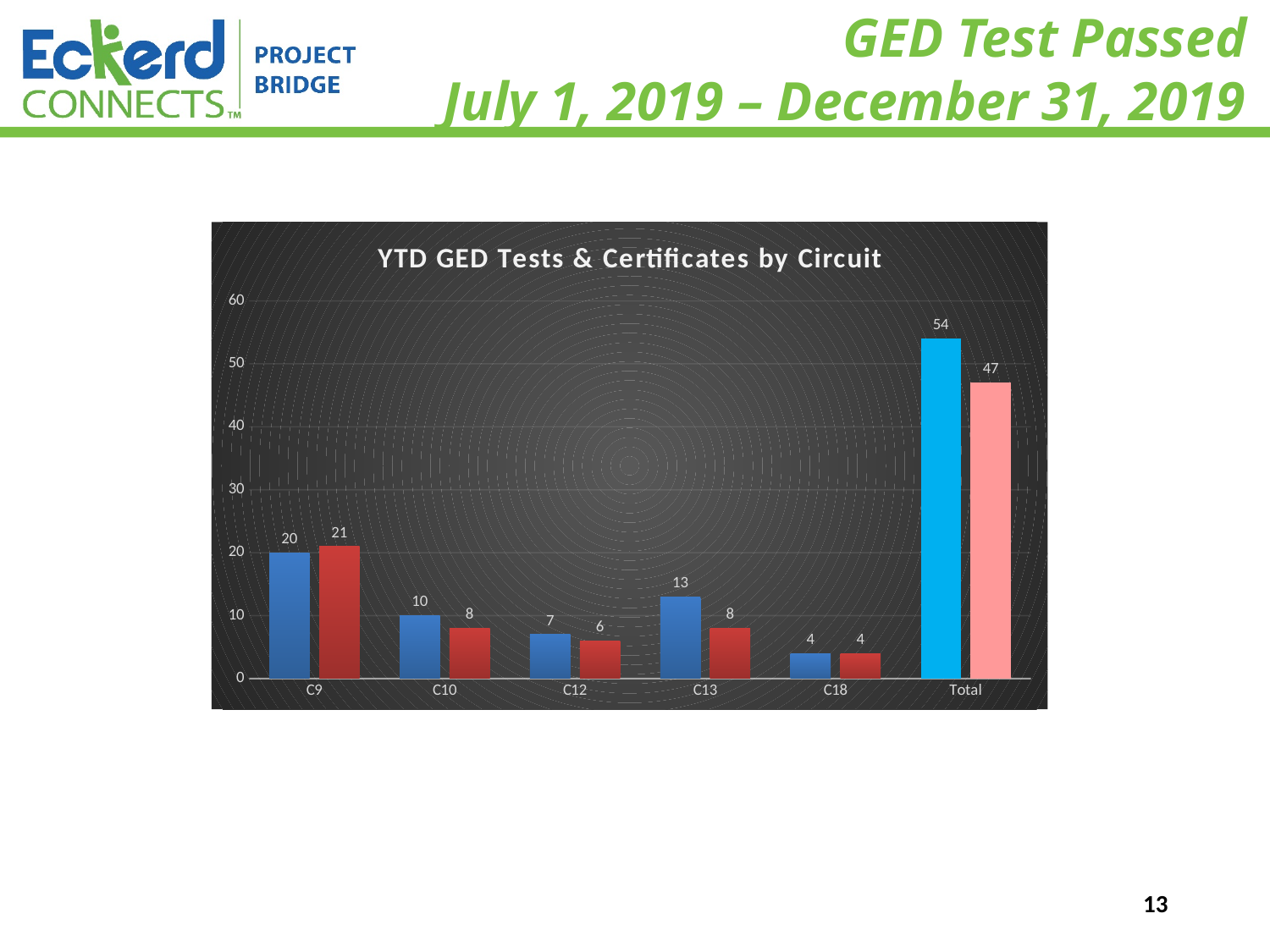
What kind of chart is shown on the slide? bar chart What is the value of the first (blue) bar for C9? 20 What is the value of the second (pink) bar for Total? 47 Among the circuits C9, C10, C12, C13 and C18, which has the lowest second (red) bar? C18 How many categories are shown on the x axis? 6 What is the difference between the two Total bars (54 and 47)? 7 What is the value of the first (blue) bar for Total? 54 What is the chart's title? YTD GED Tests & Certificates by Circuit What is the difference between the first (blue) bar for C9 and the first (blue) bar for C10? 10 What is the value of the second (red) bar for C13? 8 Among the circuits C9, C10, C12, C13 and C18, which has the highest first (blue) bar? C9 For C13, which is larger: the first (blue) bar or the second (red) bar? the first (blue) bar